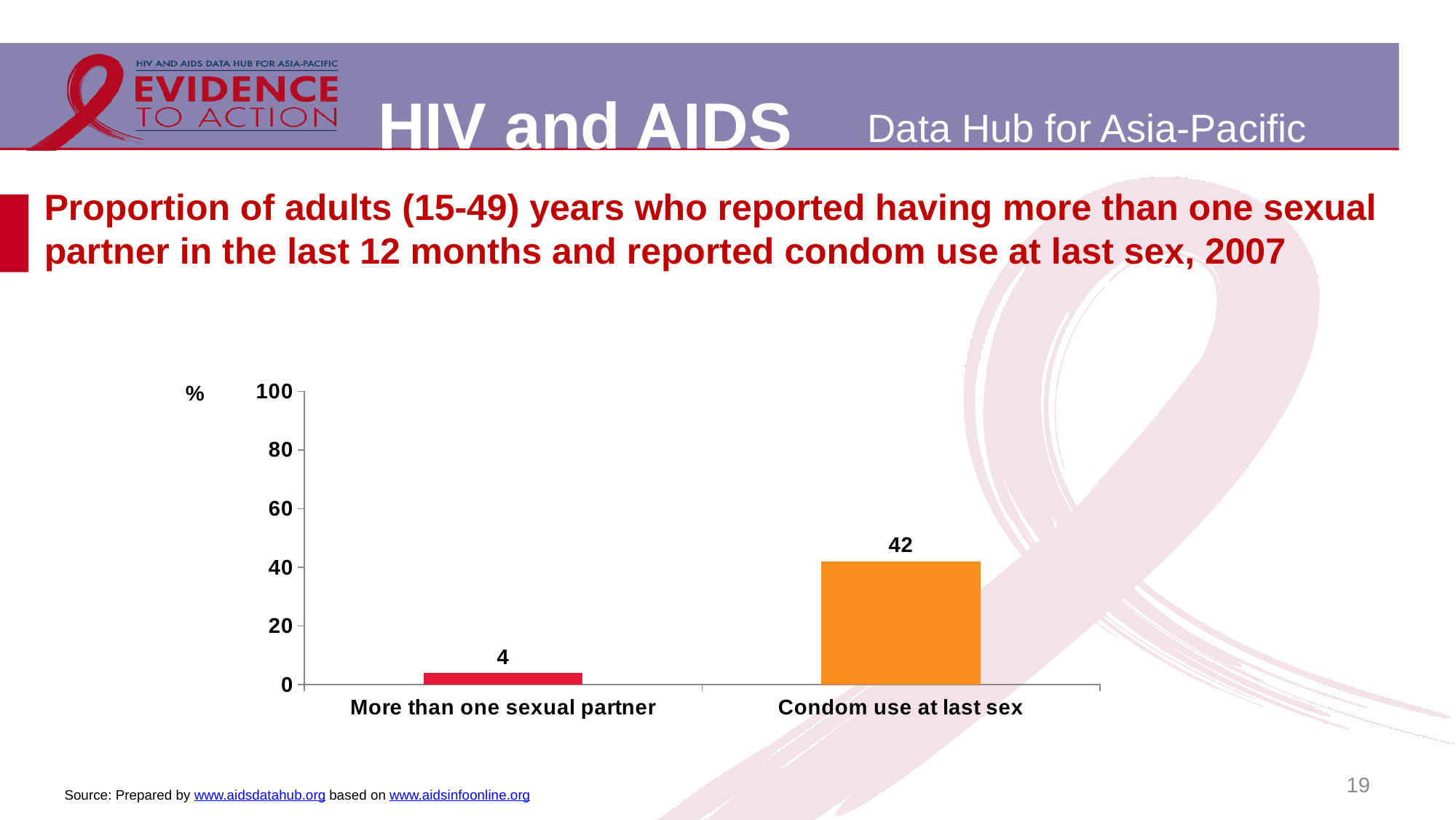
Which is larger: the value for "More than one sexual partner" or the value for "Condom use at last sex"? Condom use at last sex Which category has the lowest value? More than one sexual partner What kind of chart is shown on the slide? Bar chart Is the value for "Condom use at last sex" greater or less than 60? less Is the value for "More than one sexual partner" greater or less than 20? less What is the value for "More than one sexual partner"? 4 What is the value for "Condom use at last sex"? 42 What colour is the bar for "Condom use at last sex"? Orange How many categories are shown on the x axis? 2 What unit is shown on the y axis of the chart? % Which category has the highest value? Condom use at last sex What is the difference between the values for "Condom use at last sex" and "More than one sexual partner"? 38